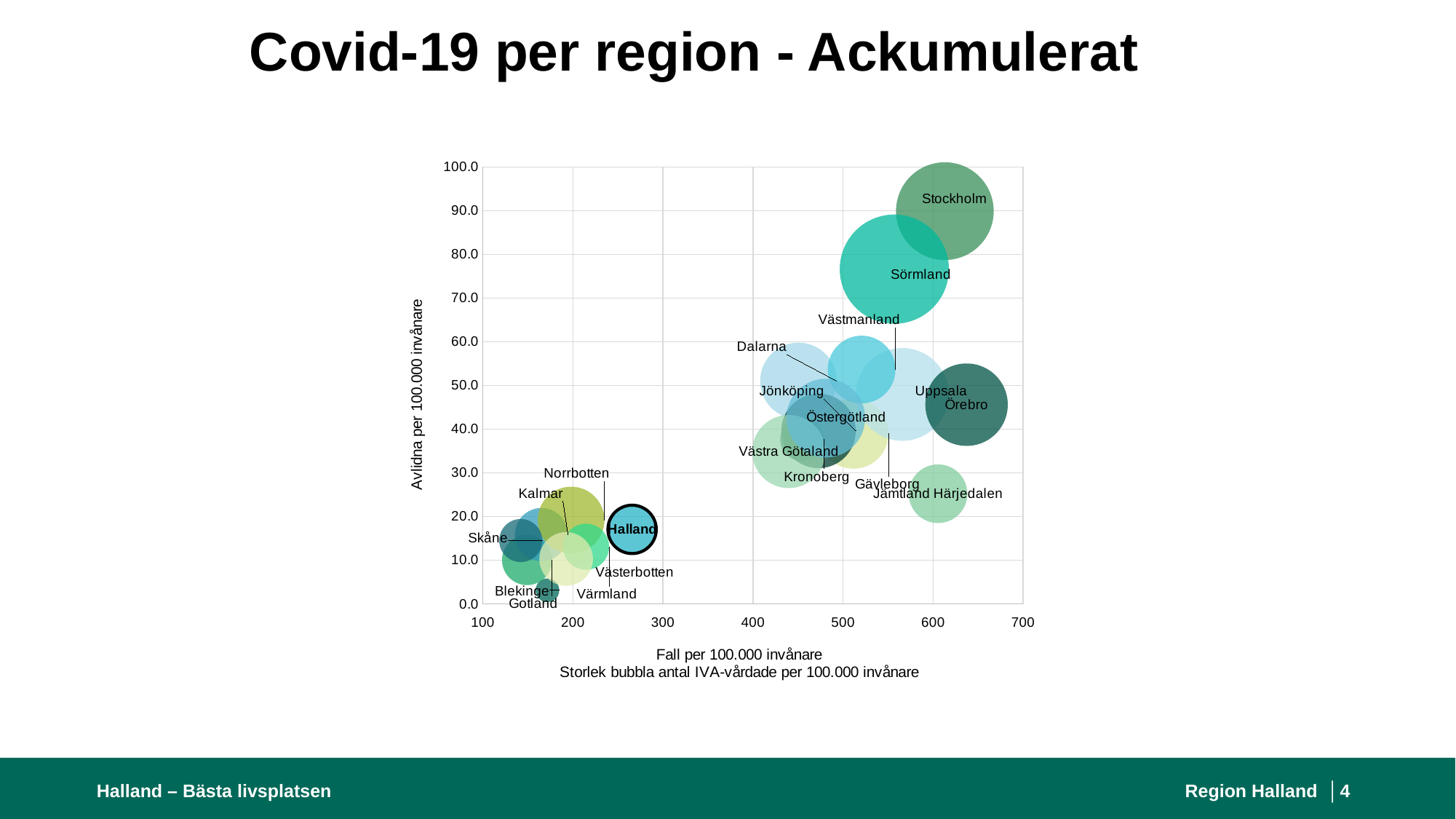
What does the size of each bubble represent according to the axis label? Antal IVA-vårdade per 100.000 invånare What kind of chart is shown on the slide? Bubble chart Which region has more Avlidna per 100.000 invånare, Stockholm or Halland? Stockholm Is the value of Fall per 100.000 invånare for Örebro greater or less than 600? greater Which region has the highest value for Avlidna per 100.000 invånare? Stockholm Which region has the lowest value for Fall per 100.000 invånare? Skåne Is the value of Fall per 100.000 invånare for Halland greater or less than 300? less Is the value of Avlidna per 100.000 invånare for Stockholm greater or less than 80? greater Which region's bubble is highlighted with a bold black outline? Halland Which region has more Fall per 100.000 invånare, Uppsala or Kalmar? Uppsala